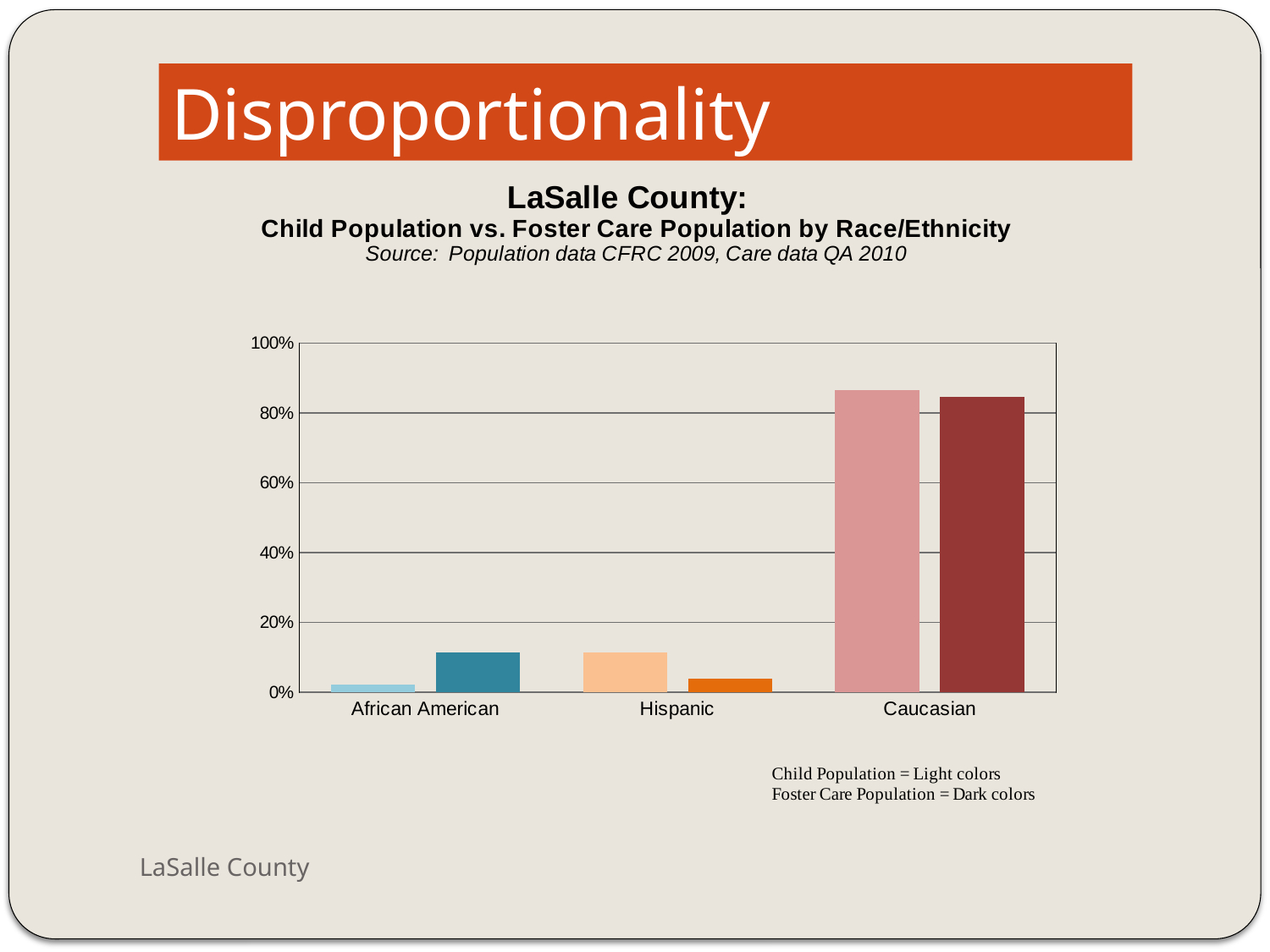
Which category has the lowest Child Population bar? African American For Hispanic, which is larger: the Child Population bar or the Foster Care Population bar? Child Population Is the Child Population value for Hispanic greater or less than 20%? less Is the Foster Care Population value for African American greater or less than 20%? less How many race/ethnicity categories are shown on the x axis? 3 Which race/ethnicity category has the highest bars? Caucasian What kind of chart is shown on the slide? bar chart Is the Child Population value for Caucasian greater or less than 80%? greater What is the source given for the population data in the chart title? CFRC 2009 For African American, which is larger: the Child Population bar or the Foster Care Population bar? Foster Care Population According to the note on the slide, what do the dark-colored bars represent? Foster Care Population